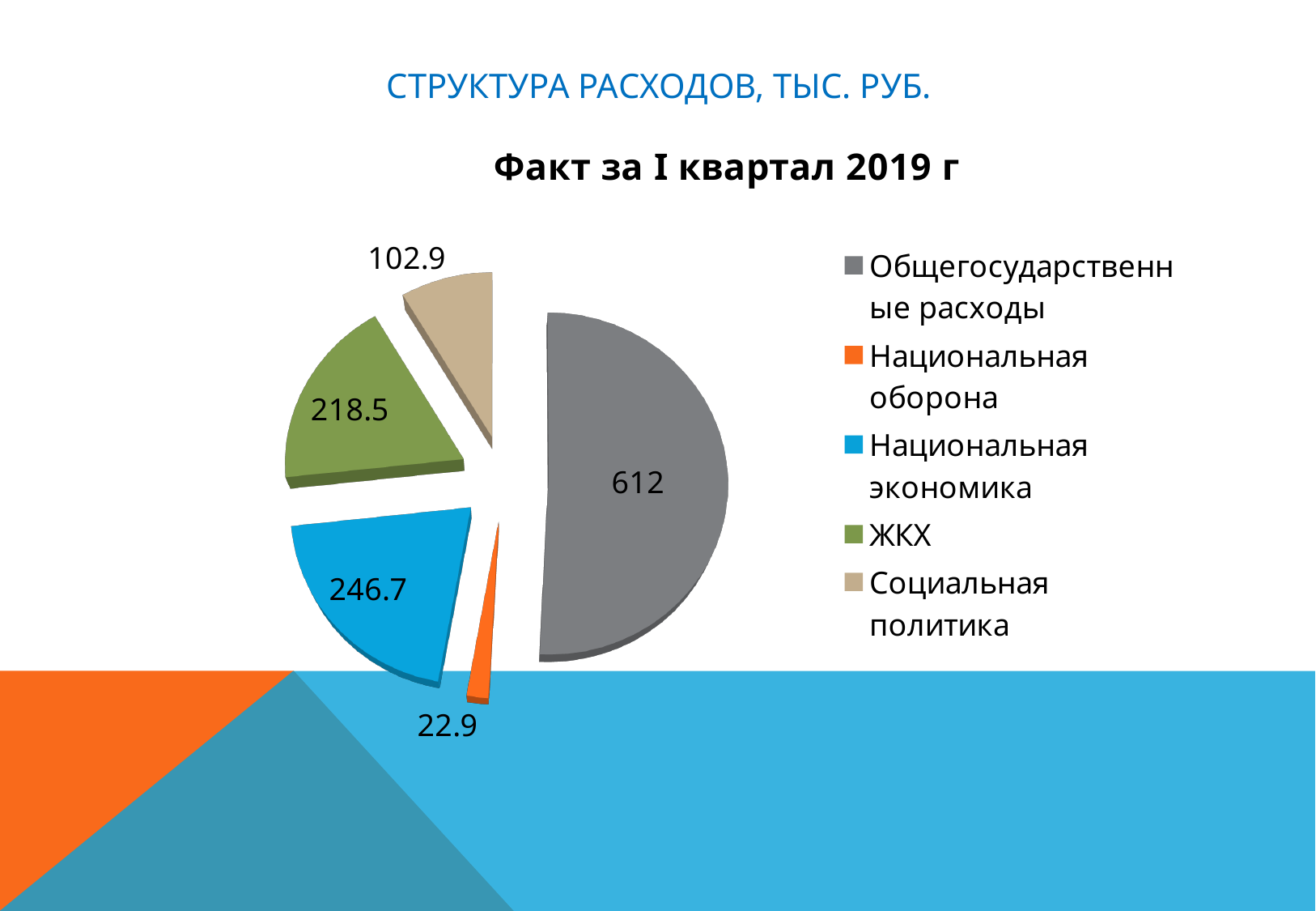
What is the title of the chart? Факт за I квартал 2019 г What is the difference between the values for Национальная экономика and ЖКХ? 28.2 What is the value for ЖКХ? 218.5 What is the value for Социальная политика? 102.9 How many categories does the pie chart show? 5 What is the value for Национальная экономика? 246.7 Which category has the smallest slice of the pie? Национальная оборона Which category has the largest slice of the pie? Общегосударственные расходы What type of chart is shown on the slide? Pie chart What is the difference between the values for Общегосударственные расходы and Национальная экономика? 365.3 What is the value for Общегосударственные расходы? 612 Which is larger, the value for ЖКХ or the value for Социальная политика? ЖКХ